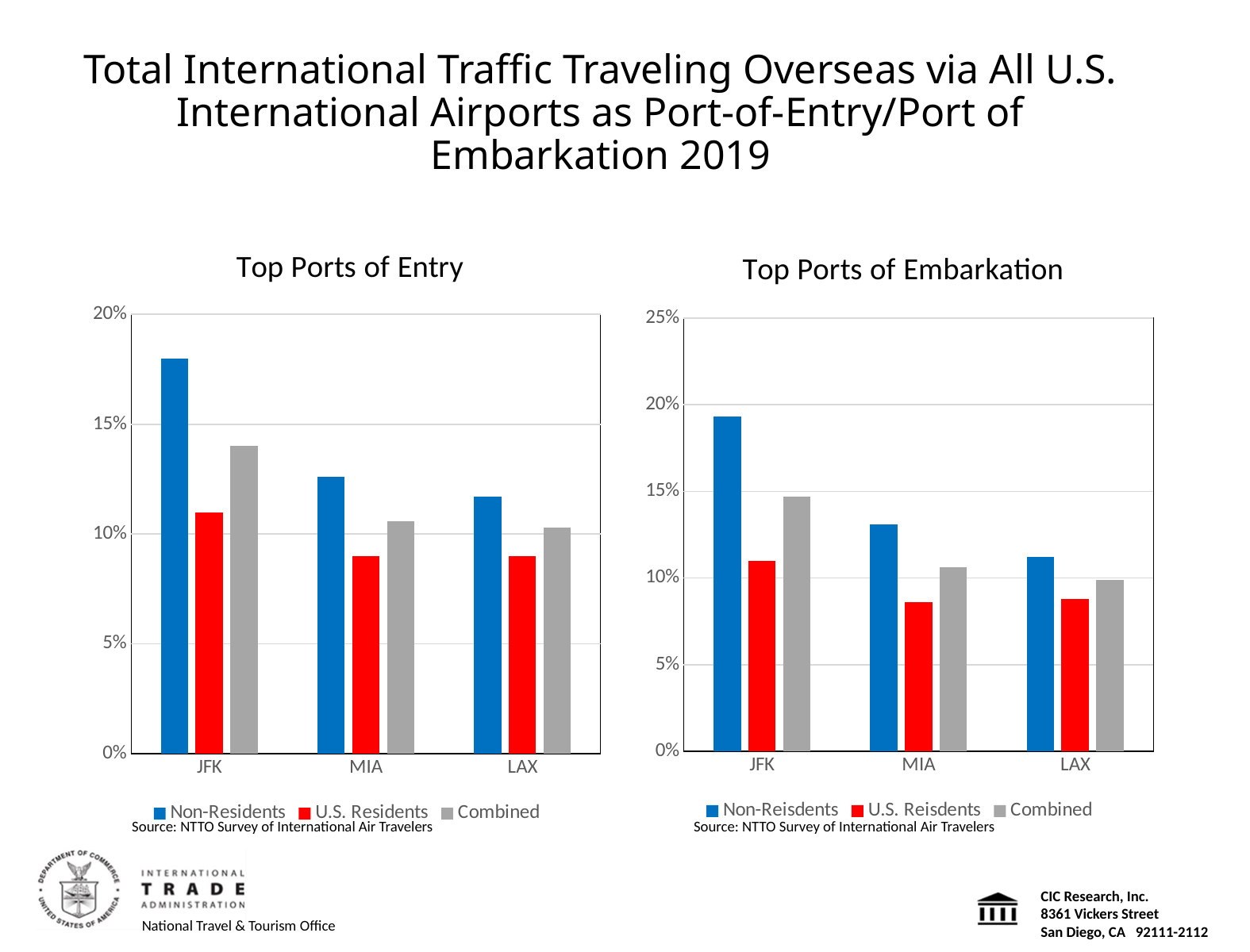
In the 'Top Ports of Embarkation' chart, is the U.S. Reisdents value for MIA greater or less than 10%? less In the 'Top Ports of Embarkation' chart, which airport has the lowest Non-Reisdents value? LAX In the 'Top Ports of Entry' chart, is the U.S. Residents value for MIA greater or less than 10%? less In the 'Top Ports of Entry' chart, is the Non-Residents value for JFK greater or less than 15%? greater In the 'Top Ports of Entry' chart, do the Combined values rise or fall from JFK to LAX? fall In the 'Top Ports of Embarkation' chart, which is larger, the Non-Reisdents value for MIA or for LAX? MIA In the 'Top Ports of Entry' chart, which airport has the highest Non-Residents value? JFK In the 'Top Ports of Entry' chart, how many series does the legend list? 3 In the 'Top Ports of Embarkation' chart, what colour represents the Combined series? gray In the 'Top Ports of Entry' chart, how many airports are shown on the x axis? 3 What kind of chart is the 'Top Ports of Entry' chart? bar chart